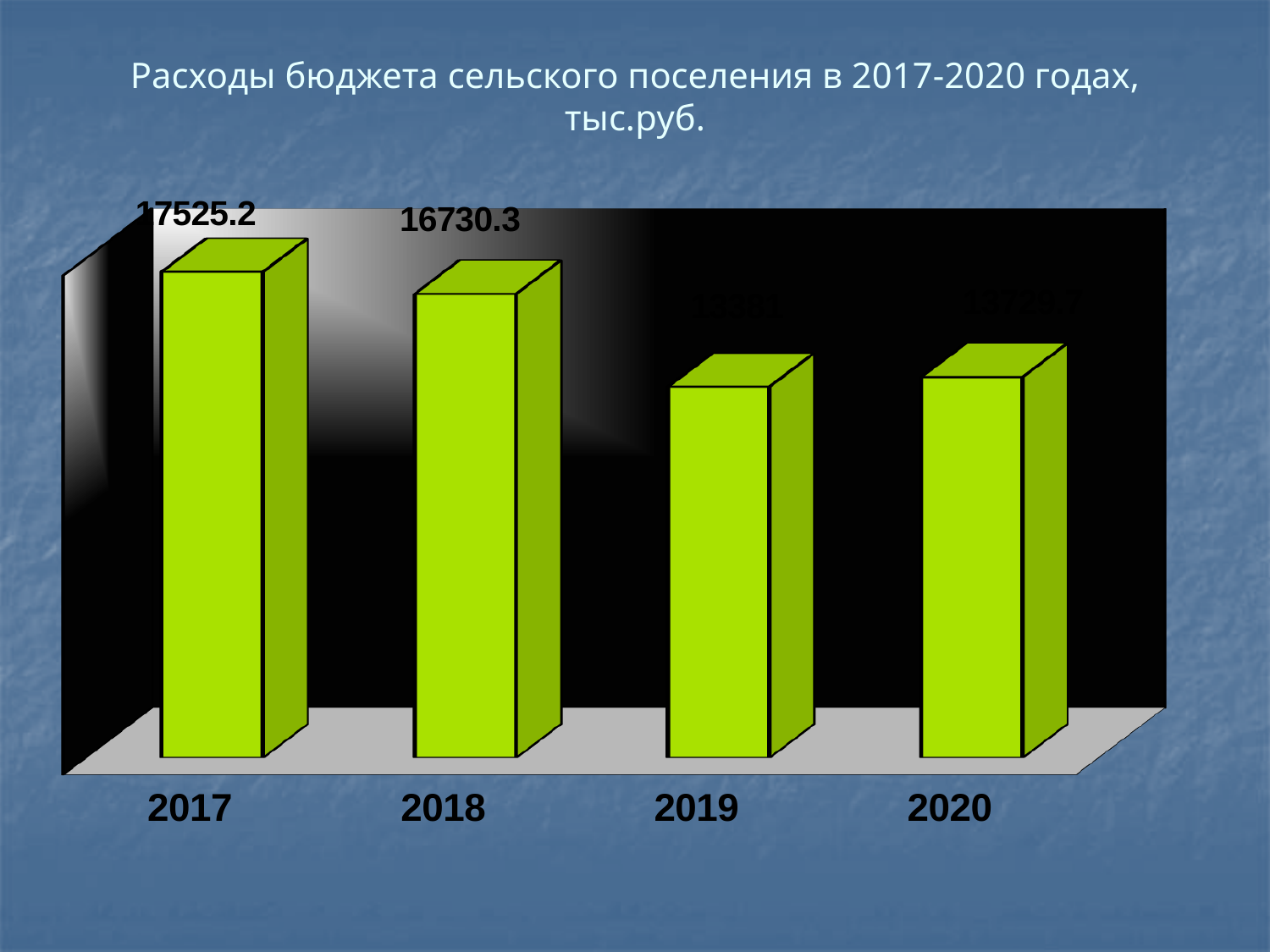
What is the difference between the values for 2017 and 2018? 794.9 What is the value for 2017? 17525.2 Do the values rise or fall from 2017 to 2019? fall What colour are the bars on the chart? green Which is larger, the value for 2017 or the value for 2018? 2017 What is the value for 2018? 16730.3 Which is larger, the value for 2018 or the value for 2019? 2018 Which year has the highest budget expenses? 2017 How many years are shown on the chart? 4 What kind of chart is shown on the slide? bar chart What is the title of the chart? Расходы бюджета сельского поселения в 2017-2020 годах, тыс.руб.